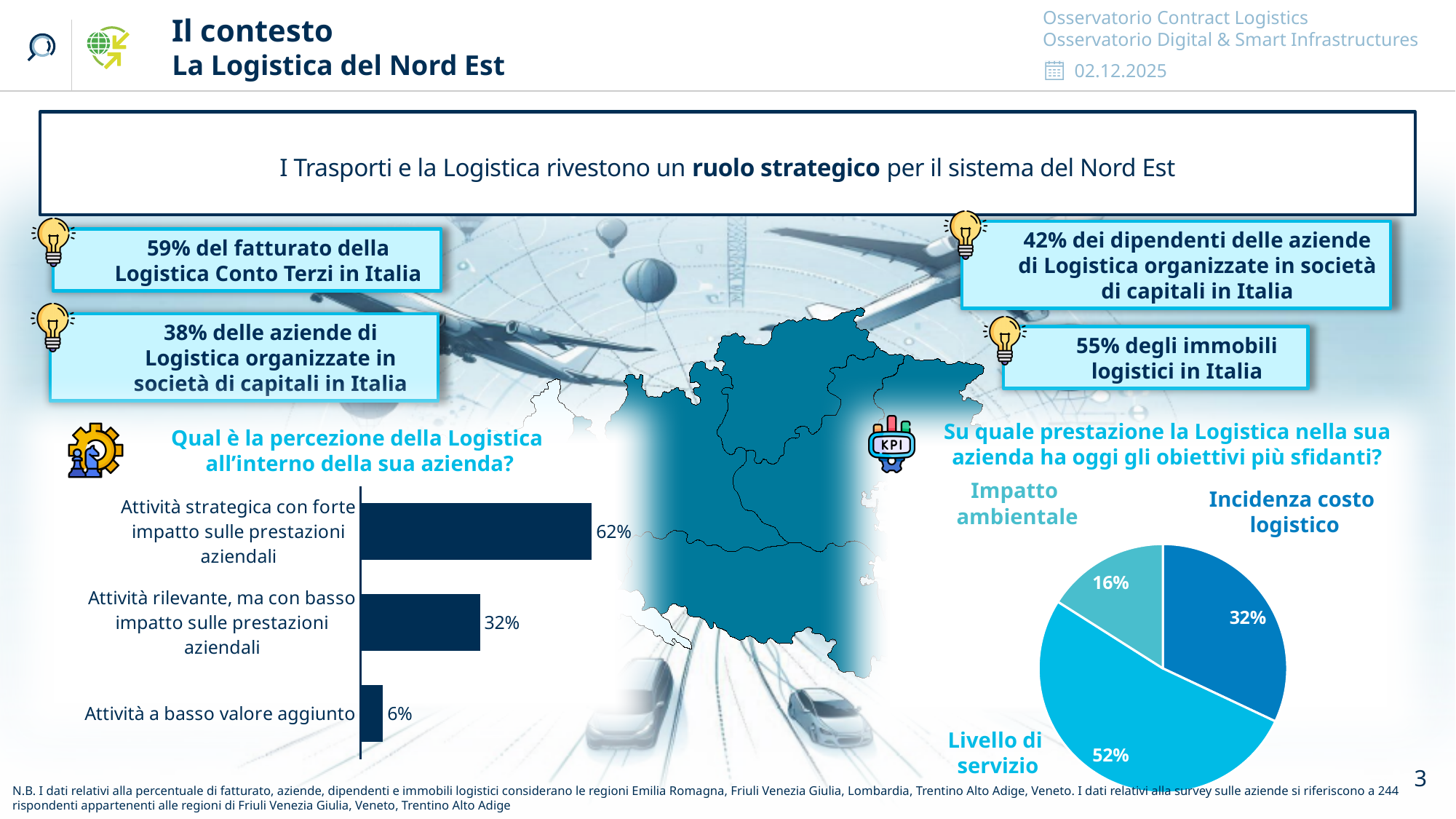
In the bar chart 'Qual è la percezione della Logistica all'interno della sua azienda?', what is the value for 'Attività a basso valore aggiunto'? 6% In the bar chart 'Qual è la percezione della Logistica all'interno della sua azienda?', which category has the lowest value? Attività a basso valore aggiunto In the pie chart 'Su quale prestazione la Logistica nella sua azienda ha oggi gli obiettivi più sfidanti?', which is larger: 'Incidenza costo logistico' or 'Impatto ambientale'? Incidenza costo logistico How many categories does the bar chart 'Qual è la percezione della Logistica all'interno della sua azienda?' show? 3 In the bar chart 'Qual è la percezione della Logistica all'interno della sua azienda?', what is the difference between 'Attività strategica con forte impatto sulle prestazioni aziendali' and 'Attività rilevante, ma con basso impatto sulle prestazioni aziendali'? 30% In the pie chart 'Su quale prestazione la Logistica nella sua azienda ha oggi gli obiettivi più sfidanti?', what is the share for 'Livello di servizio'? 52% What kind of chart is the one titled 'Qual è la percezione della Logistica all'interno della sua azienda?'? Bar chart In the pie chart 'Su quale prestazione la Logistica nella sua azienda ha oggi gli obiettivi più sfidanti?', which slice is the largest? Livello di servizio In the bar chart 'Qual è la percezione della Logistica all'interno della sua azienda?', what is the value for 'Attività strategica con forte impatto sulle prestazioni aziendali'? 62% In the bar chart 'Qual è la percezione della Logistica all'interno della sua azienda?', which category has the highest value? Attività strategica con forte impatto sulle prestazioni aziendali What kind of chart is the one titled 'Su quale prestazione la Logistica nella sua azienda ha oggi gli obiettivi più sfidanti?'? Pie chart In the pie chart 'Su quale prestazione la Logistica nella sua azienda ha oggi gli obiettivi più sfidanti?', what is the value for 'Impatto ambientale'? 16%